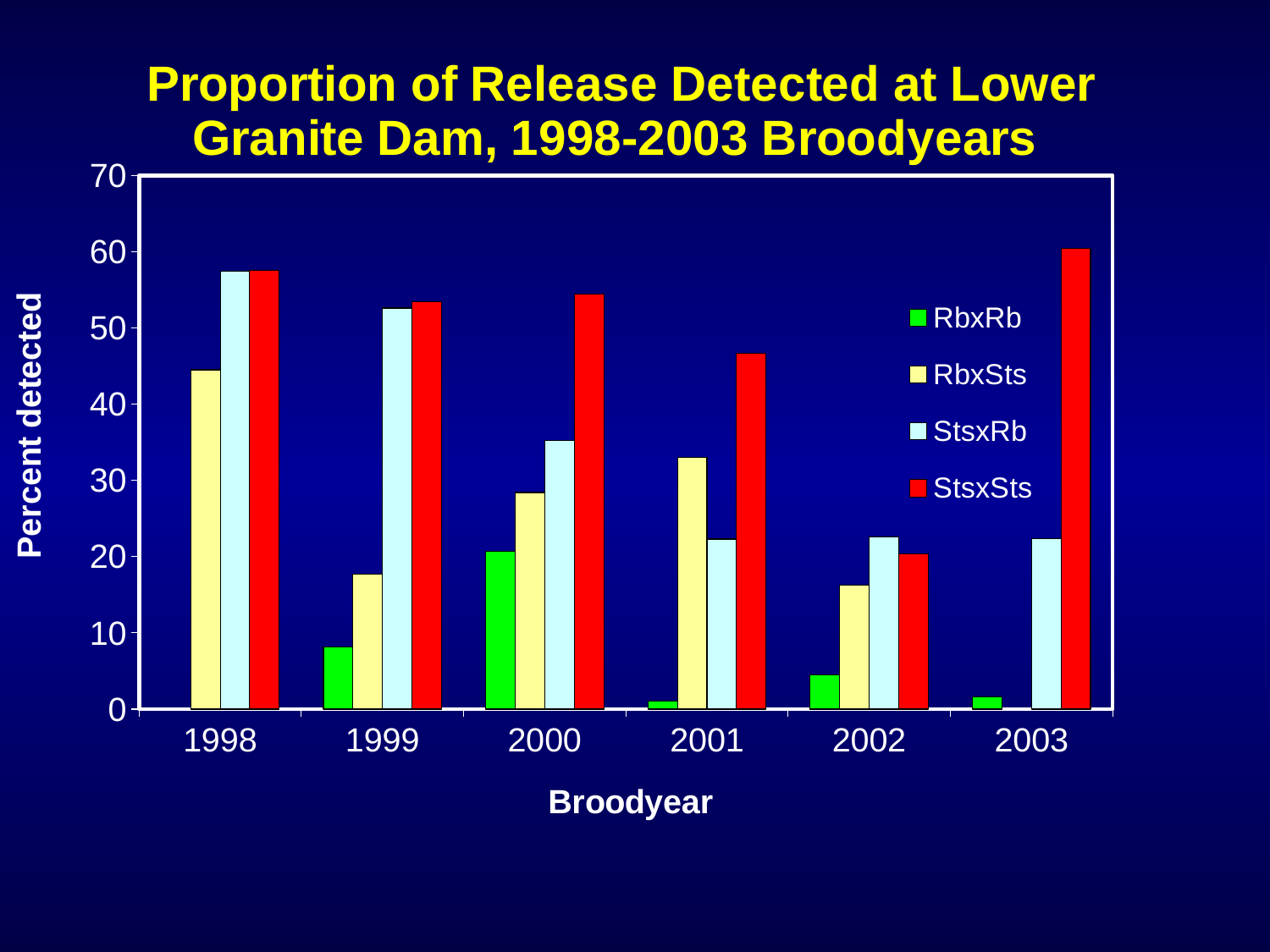
What is the label on the y axis? Percent detected Which broodyear has the lowest StsxSts value? 2002 Does the StsxRb value generally rise or fall from 1998 to 2003? fall In 2001, which is larger, the RbxSts value or the StsxRb value? RbxSts How many series does the legend list? 4 Is the StsxSts value for 2001 greater or less than 40? greater How many broodyears are shown on the x axis? 6 What kind of chart is shown on the slide? bar chart Which broodyear has the highest RbxRb value? 2000 Which broodyear has the highest StsxSts value? 2003 Is the StsxRb value for 2000 greater or less than 40? less Is the RbxRb value for 1999 greater or less than 10? less